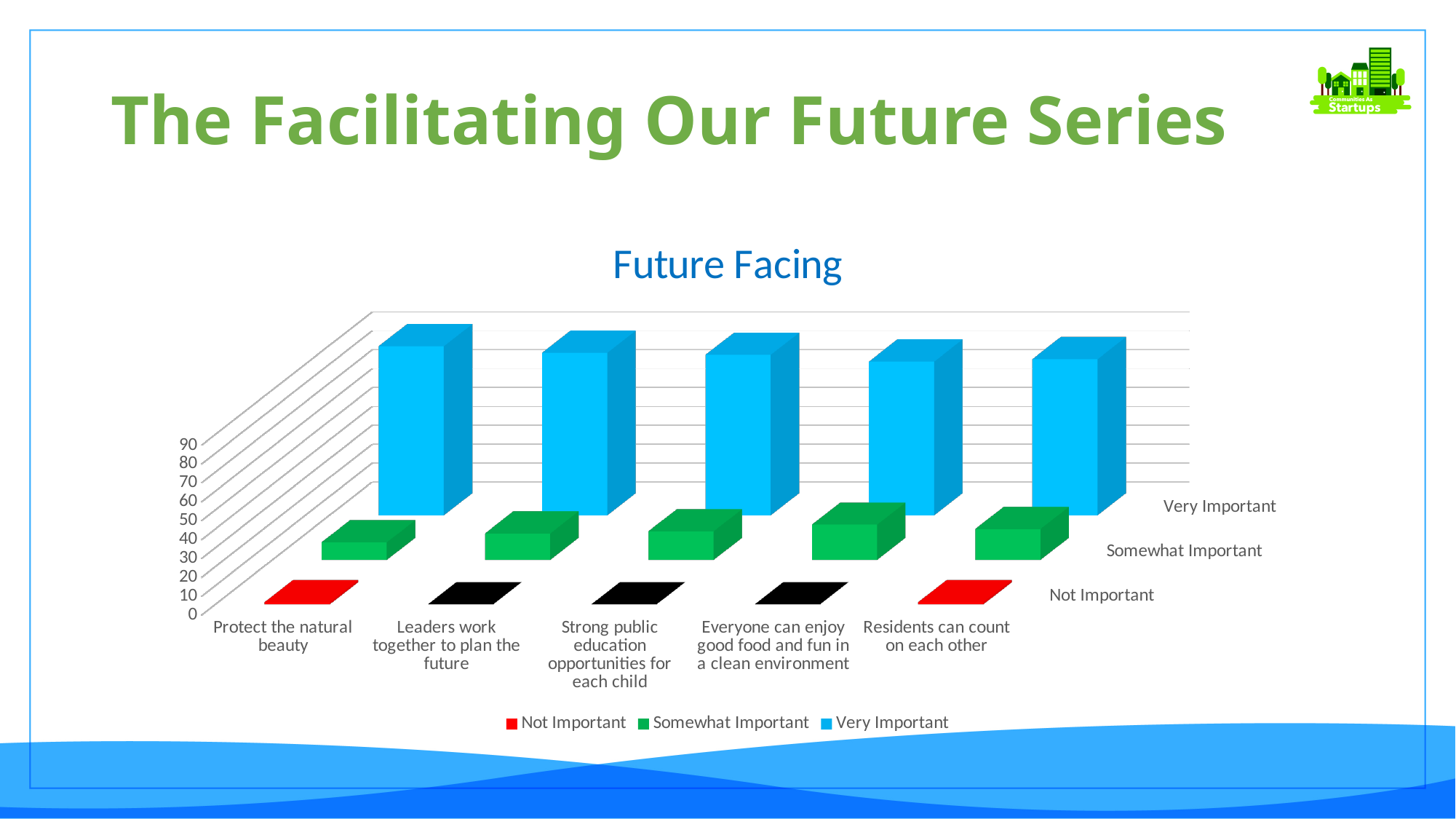
How many series does the legend of the Future Facing chart list? 3 For 'Protect the natural beauty', which is larger: Very Important or Somewhat Important? Very Important What is the title of the chart on the slide? Future Facing For 'Everyone can enjoy good food and fun in a clean environment', which is larger: Somewhat Important or Not Important? Somewhat Important Which category has the lowest Somewhat Important value? Protect the natural beauty Is the Somewhat Important value for 'Leaders work together to plan the future' greater or less than 50? less Which colour represents the Very Important series in the chart? blue How many categories are shown along the x axis of the Future Facing chart? 5 For 'Strong public education opportunities for each child', which series has the lowest value? Not Important Is the Very Important value for 'Protect the natural beauty' greater or less than 50? greater What kind of chart is shown on the slide? bar chart For 'Residents can count on each other', which series has the highest value? Very Important